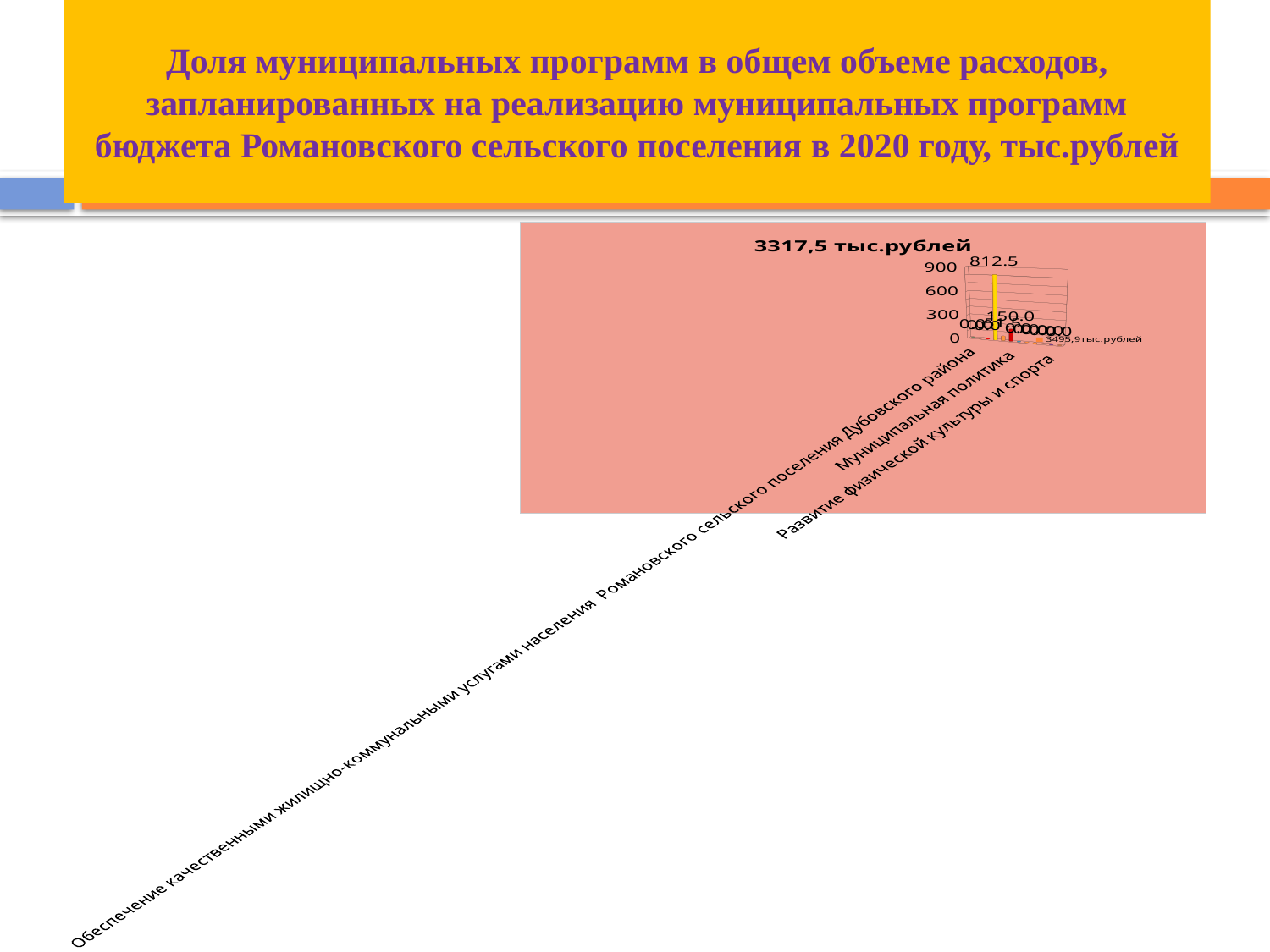
What is the highest data label printed on the chart? 812.5 What is the value for Муниципальная политика? 150.0 What is the value for Обеспечение качественными жилищно-коммунальными услугами населения Романовского сельского поселения Дубовского района? 0 What is the difference between the values 812.5 and 150.0 shown on the chart? 662.5 Is the value for Обеспечение качественными жилищно-коммунальными услугами greater or less than 600? less What is the highest tick value shown on the vertical axis? 900 Is the value for Муниципальная политика greater or less than 300? less What kind of chart is shown on the slide? bar chart Which is larger, the value for Обеспечение качественными жилищно-коммунальными услугами or the value for Муниципальная политика? Муниципальная политика What is the title of the chart? 3317,5 тыс.рублей